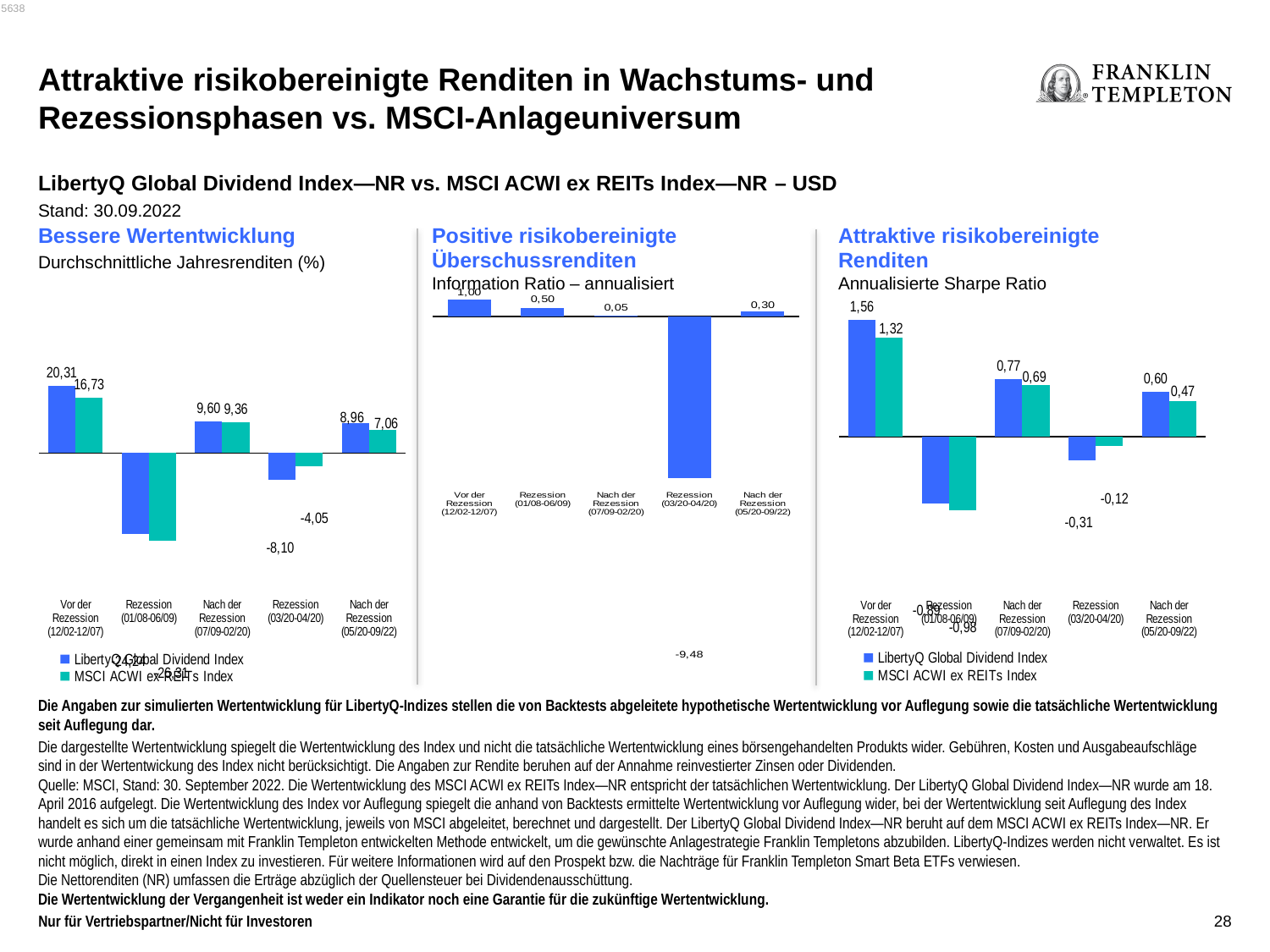
How many periods are shown on the x axis of the 'Positive risikobereinigte Überschussrenditen' chart? 5 In the 'Attraktive risikobereinigte Renditen' chart, what is the difference between the two indices' Sharpe Ratios for 'Nach der Rezession (05/20-09/22)'? 0,13 In the 'Attraktive risikobereinigte Renditen' chart, what is the Sharpe Ratio of the MSCI ACWI ex REITs Index for 'Rezession (03/20-04/20)'? -0,12 In the 'Bessere Wertentwicklung' chart, which index has the lower value in 'Rezession (03/20-04/20)'? LibertyQ Global Dividend Index In the 'Bessere Wertentwicklung' chart, what is the difference between the LibertyQ Global Dividend Index and the MSCI ACWI ex REITs Index for 'Vor der Rezession (12/02-12/07)'? 3,58 What type of chart is the 'Attraktive risikobereinigte Renditen' chart? Bar chart In the 'Bessere Wertentwicklung' chart, what is the average annual return of the LibertyQ Global Dividend Index for 'Vor der Rezession (12/02-12/07)'? 20,31 In the 'Attraktive risikobereinigte Renditen' chart, what is the annualised Sharpe Ratio of the LibertyQ Global Dividend Index for 'Vor der Rezession (12/02-12/07)'? 1,56 In the 'Positive risikobereinigte Überschussrenditen' chart, which period has the highest Information Ratio? Vor der Rezession (12/02-12/07) In the 'Bessere Wertentwicklung' chart, what is the value for the MSCI ACWI ex REITs Index in 'Nach der Rezession (05/20-09/22)'? 7,06 How many series does the legend of the 'Bessere Wertentwicklung' chart list? 2 In the 'Positive risikobereinigte Überschussrenditen' chart, what is the Information Ratio for 'Rezession (03/20-04/20)'? -9,48